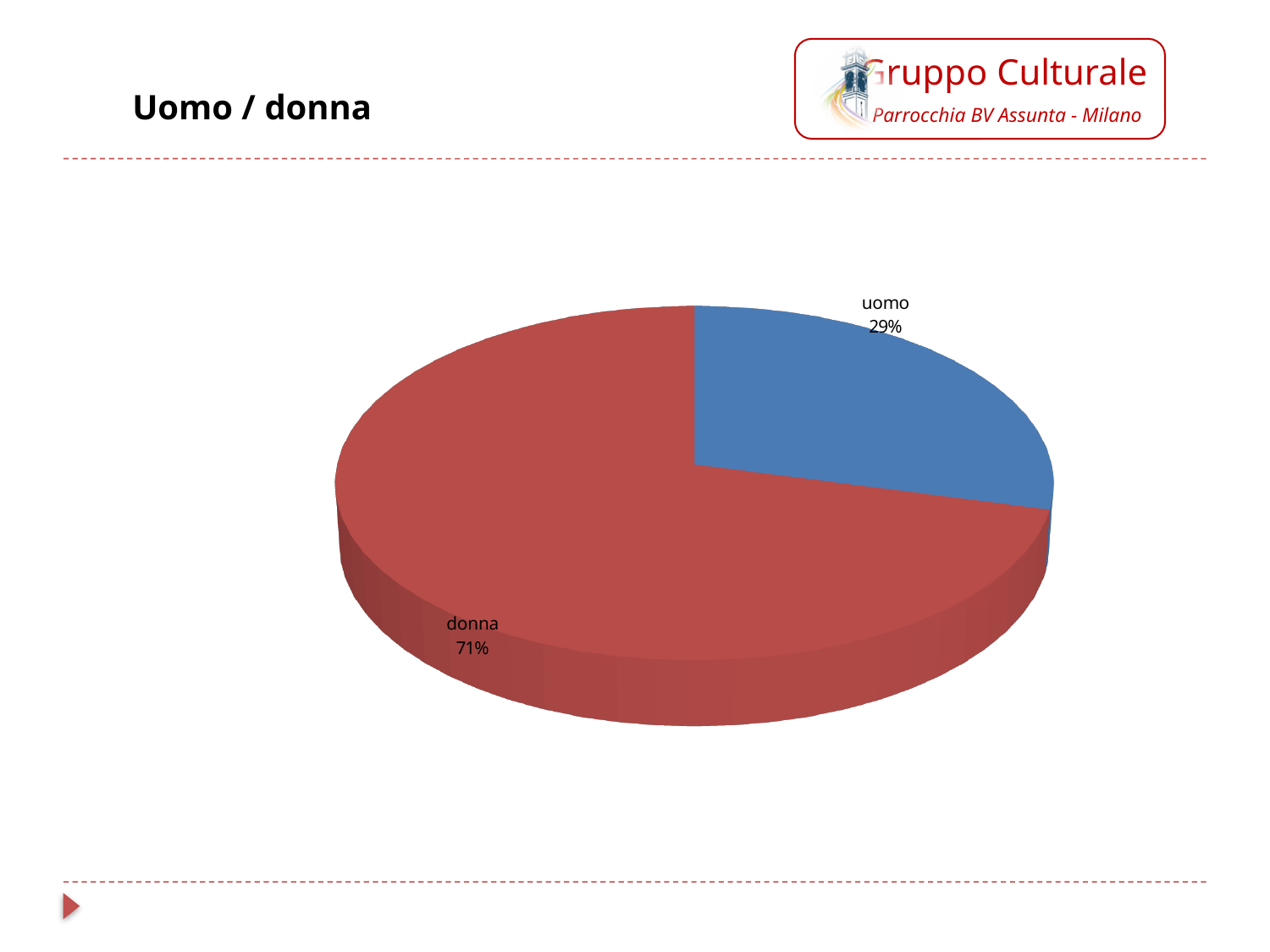
How many slices does the pie chart have? 2 What kind of chart is shown on the slide? pie chart What share of the pie does the "donna" slice represent? 71% Which slice is larger, "uomo" or "donna"? donna What is the difference in percentage points between the "donna" and "uomo" slices? 42 What share of the pie does the "uomo" slice represent? 29% Which slice is the smallest in the pie chart? uomo Which slice is the largest in the pie chart? donna What colour is the "uomo" slice in the pie chart? blue What is the title of the slide containing the pie chart? Uomo / donna